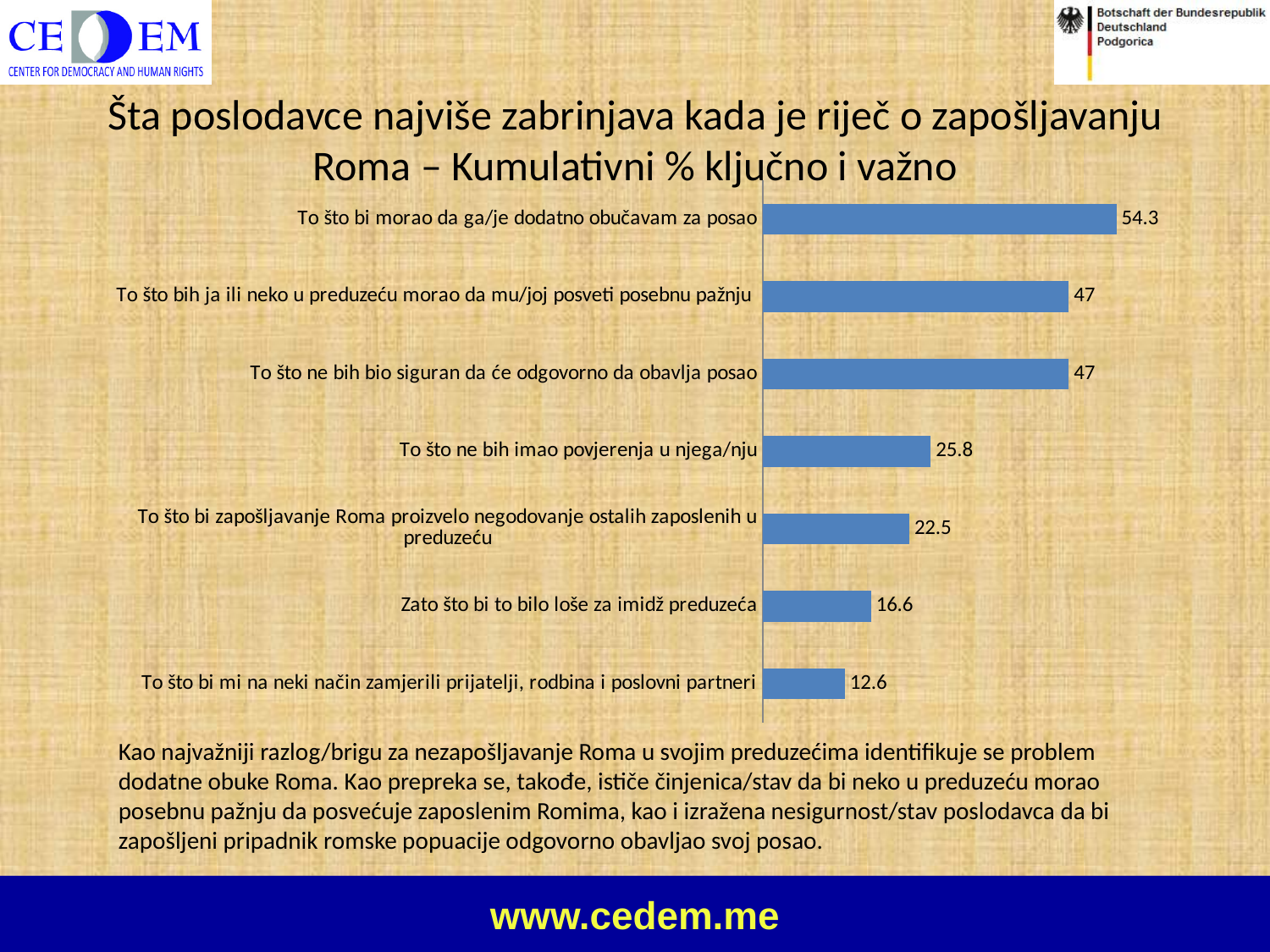
What is the value for "To što bi morao da ga/je dodatno obučavam za posao"? 54.3 Which category has the lowest value? To što bi mi na neki način zamjerili prijatelji, rodbina i poslovni partneri Which is larger: the value for "Zato što bi to bilo loše za imidž preduzeća" or the value for "To što bi zapošljavanje Roma proizvelo negodovanje ostalih zaposlenih u preduzeću"? To što bi zapošljavanje Roma proizvelo negodovanje ostalih zaposlenih u preduzeću What is the value for "Zato što bi to bilo loše za imidž preduzeća"? 16.6 How many categories are shown in the chart? 7 What colour are the bars in the chart? Blue What kind of chart is shown on the slide? Bar chart Which category has the highest value? To što bi morao da ga/je dodatno obučavam za posao What is the difference between the value for "To što ne bih imao povjerenja u njega/nju" and the value for "To što bi zapošljavanje Roma proizvelo negodovanje ostalih zaposlenih u preduzeću"? 3.3 What is the value for "To što bi mi na neki način zamjerili prijatelji, rodbina i poslovni partneri"? 12.6 What is the difference between the value for "To što bi morao da ga/je dodatno obučavam za posao" and the value for "To što bih ja ili neko u preduzeću morao da mu/joj posveti posebnu pažnju"? 7.3 What is the value for "To što ne bih imao povjerenja u njega/nju"? 25.8